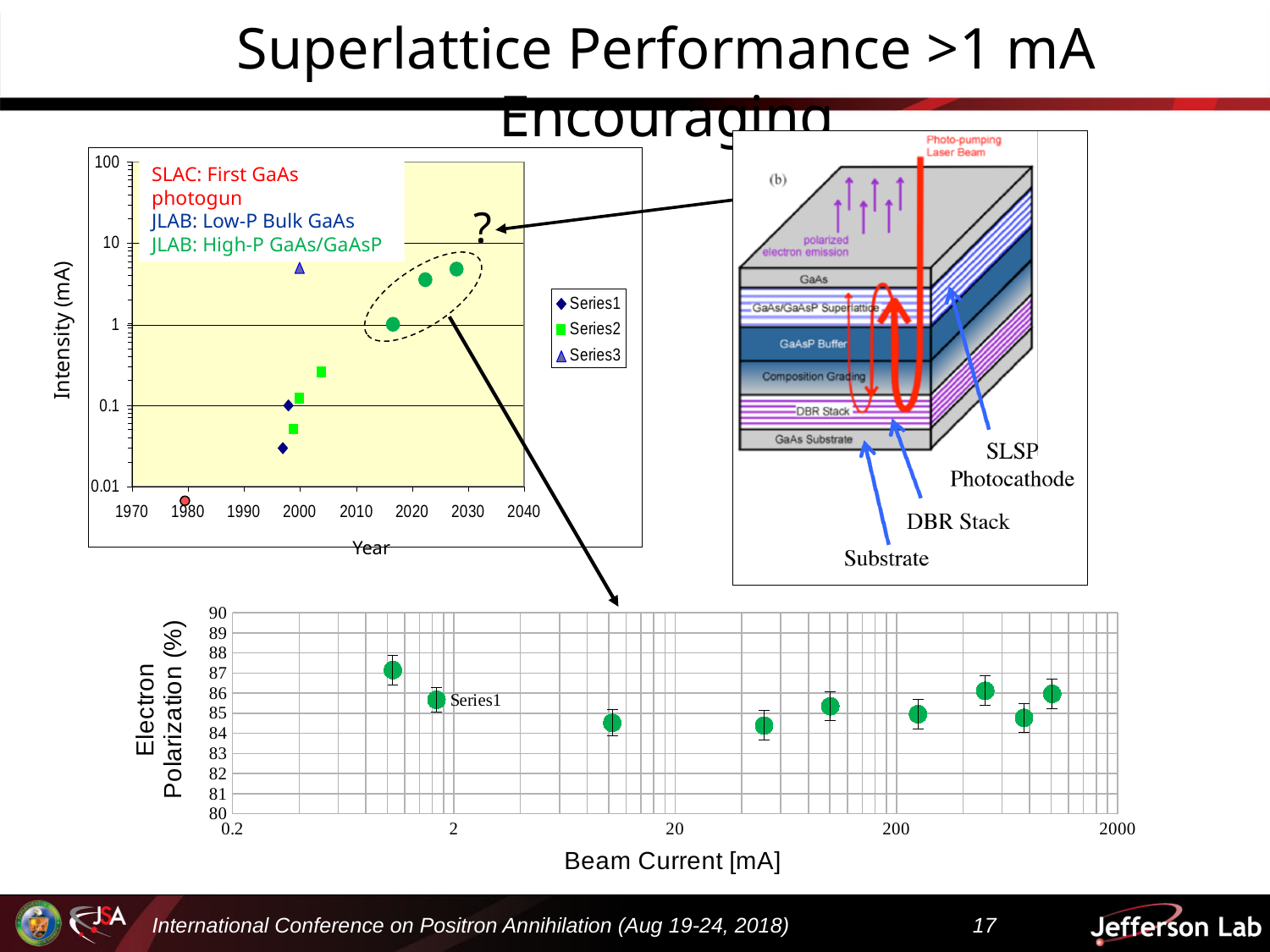
What kind of chart is the top-left chart of Intensity versus Year? scatter chart How many series does the legend of the top-left Intensity versus Year chart list? 3 How many data points are plotted in the bottom Electron Polarization versus Beam Current chart? 9 In the top-left Intensity versus Year chart, is the Series3 point greater or less than 1 mA? greater In the bottom Electron Polarization chart, is the leftmost point (near 1 mA) greater or less than 86%? greater In the top-left Intensity versus Year chart, which series is shown with triangle markers? Series3 In the top-left Intensity versus Year chart, are the Series1 points greater or less than 1 mA? less In the top-left Intensity versus Year chart, how many Series3 points are plotted? 1 What is the label of the y axis of the top-left chart? Intensity (mA) What kind of chart is the bottom chart of Electron Polarization versus Beam Current? scatter chart How many series does the bottom Electron Polarization chart show? 1